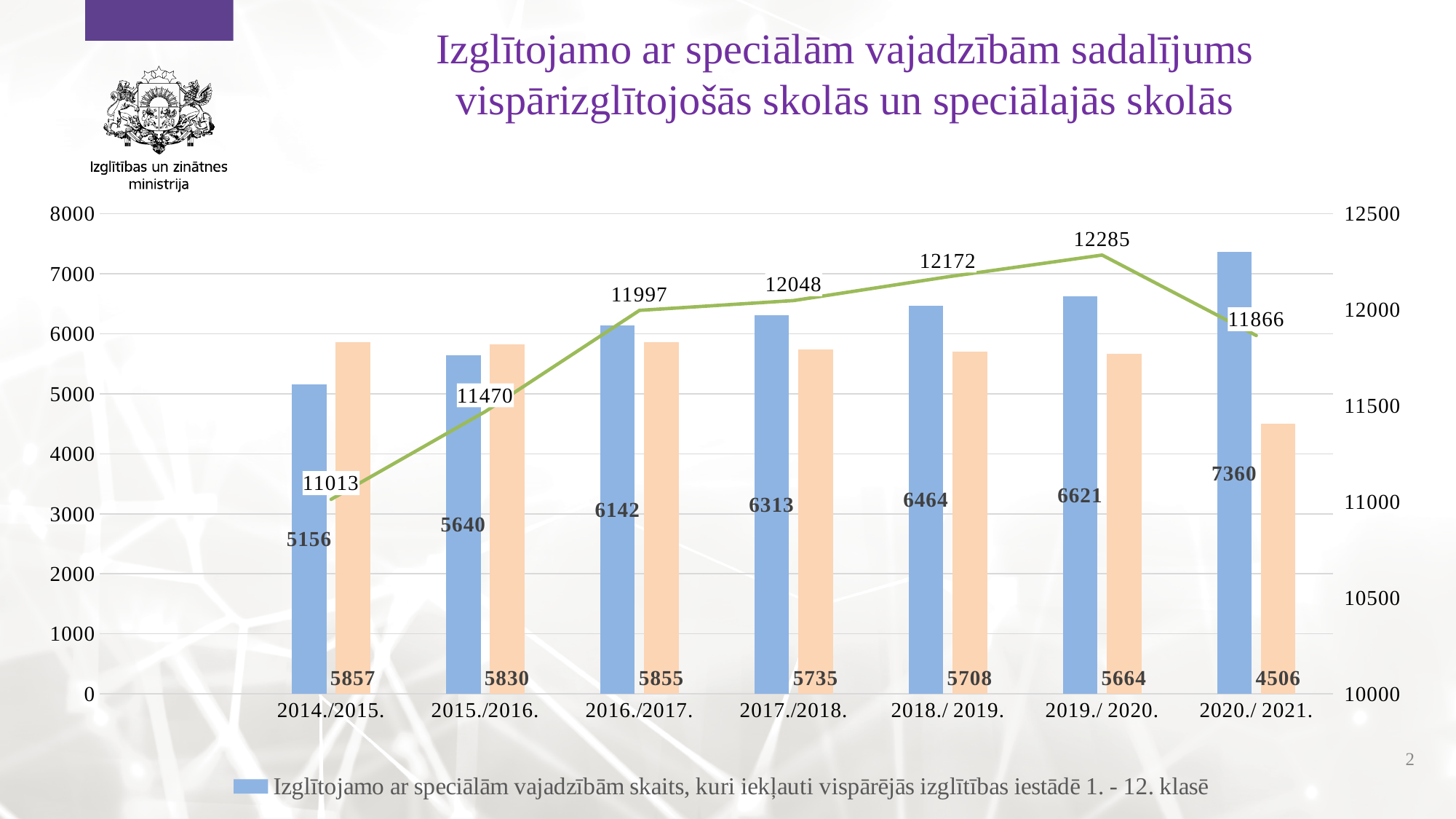
What is the value of the orange bar for 2014./2015.? 5857 What is the value of the blue bar for 2020./ 2021.? 7360 For 2016./2017., which is larger: the blue bar or the orange bar? the blue bar (6142) In which school year is the blue bar the highest? 2020./ 2021. In which school year does the green line reach its highest value? 2019./ 2020. In which school year is the orange bar the lowest? 2020./ 2021. How many school years are shown on the x axis? 7 What kind of chart is shown on the slide? a bar chart combined with a line chart Do the blue bar values rise or fall from 2014./2015. to 2020./ 2021.? rise What is the difference between the green line values for 2019./ 2020. and 2020./ 2021.? 419 By how much does the blue bar value for 2020./ 2021. exceed the blue bar value for 2014./2015.? 2204 What value does the green line show for 2018./ 2019.? 12172